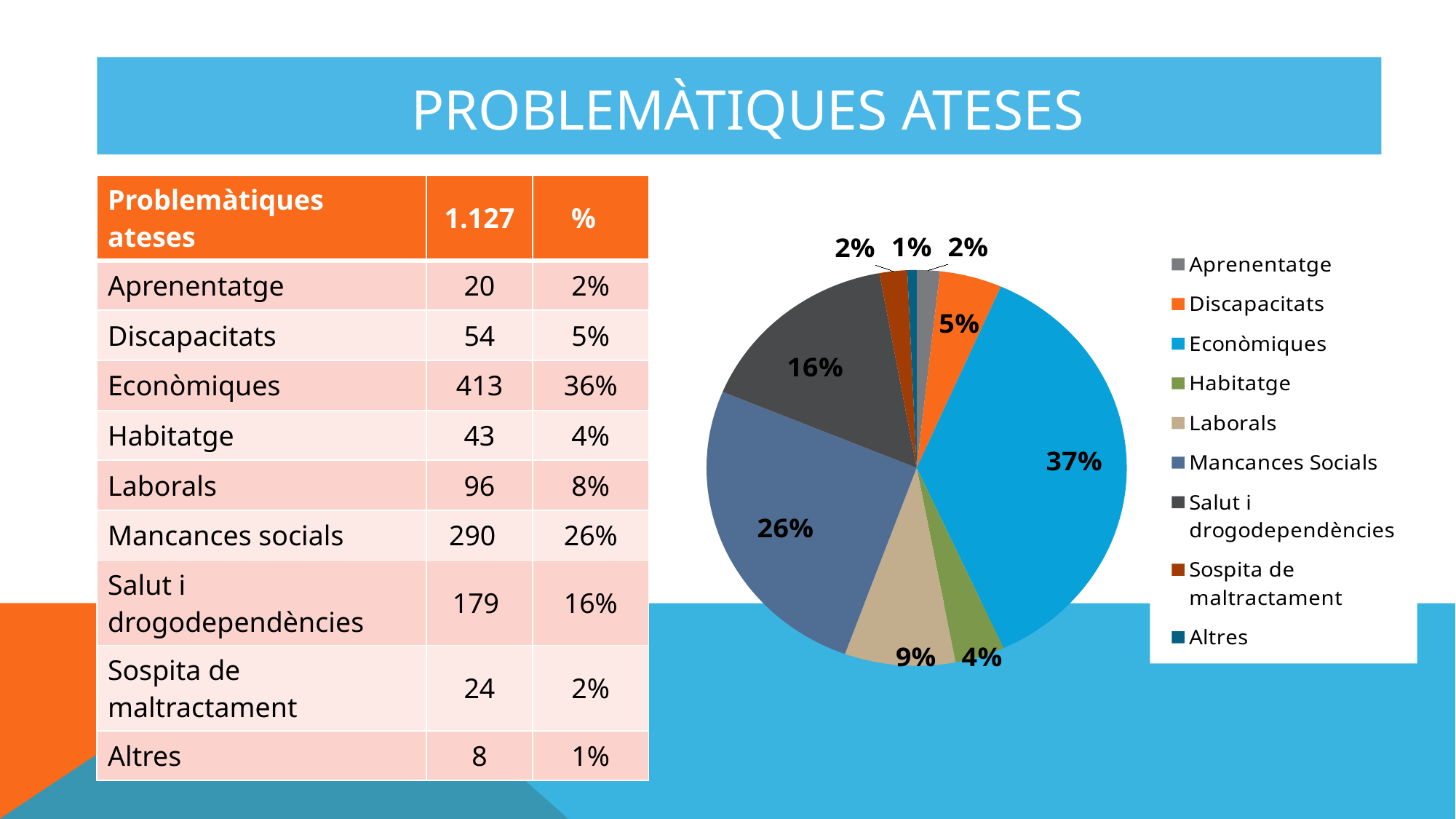
What share of the pie does Laborals take? 9% What share of the pie does Discapacitats take? 5% What share of the pie does Econòmiques take? 37% What is the difference in percentage points between the Econòmiques slice and the Mancances Socials slice? 11% What kind of chart is shown on the slide? pie chart Which slice is larger, Mancances Socials or Salut i drogodependències? Mancances Socials Which category has the largest slice of the pie? Econòmiques Which category has the smallest slice of the pie? Altres How many categories does the legend of the pie chart list? 9